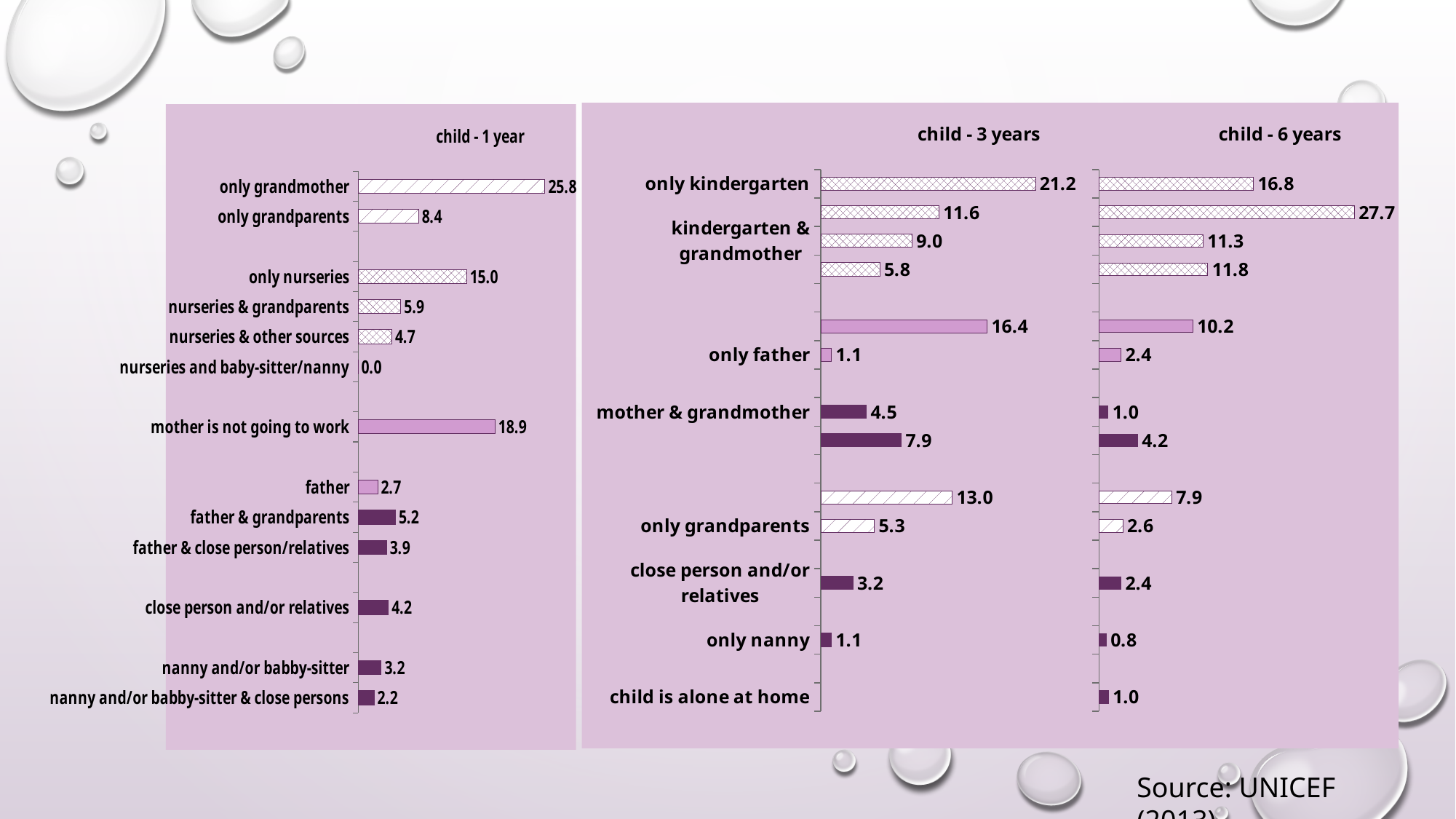
In the 'child - 1 year' chart, which is larger: 'father & grandparents' or 'father & close person/relatives'? father & grandparents In the right-hand chart, what is the value for 'only kindergarten' for a child of 6 years? 16.8 In the right-hand chart, what is the value for 'child is alone at home' for a child of 6 years? 1.0 In the 'child - 1 year' chart, which category has the lowest value? nurseries and baby-sitter/nanny In the right-hand chart, what is the difference between 'only grandparents' for a child of 3 years and for a child of 6 years? 2.7 In the 'child - 1 year' chart, what is the value for 'mother is not going to work'? 18.9 What kind of chart is the 'child - 1 year' chart? bar chart In the 'child - 1 year' chart, what is the difference between 'only nurseries' and 'nurseries & grandparents'? 9.1 In the right-hand chart, what is the value for 'only father' for a child of 6 years? 2.4 In the right-hand chart, what is the value for 'only kindergarten' for a child of 3 years? 21.2 In the 'child - 1 year' chart, what is the value for 'only grandmother'? 25.8 In the 'child - 1 year' chart, which category has the highest value? only grandmother